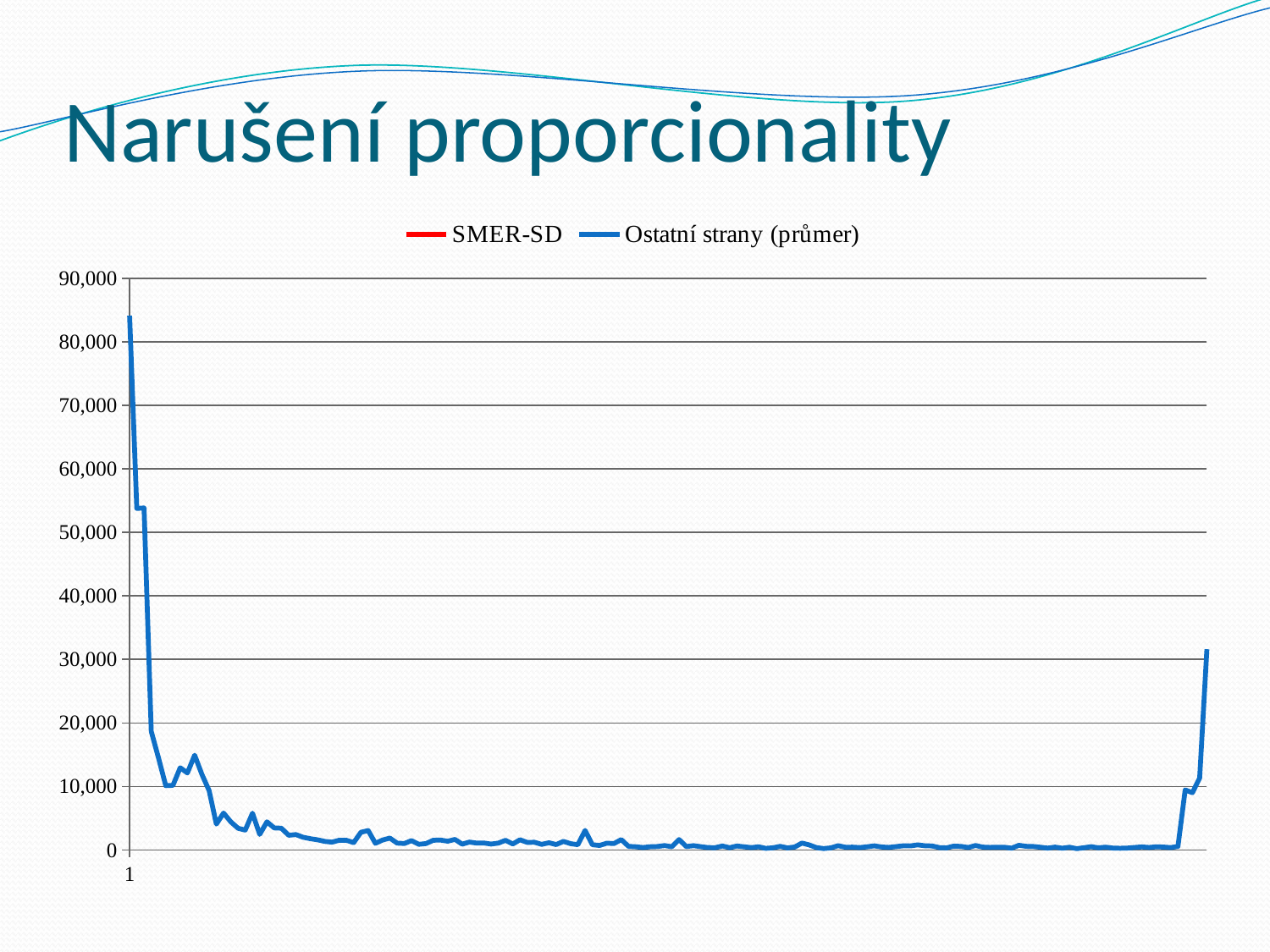
What are the two series named in the legend? SMER-SD and Ostatní strany (průmer) What colour is the line for Ostatní strany (průmer) in the legend? blue Where along the x axis does the Ostatní strany (průmer) line reach its highest value: at the start, in the middle, or at the end? at the start Is the first value of the Ostatní strany (průmer) line larger or smaller than its last value? larger Does the Ostatní strany (průmer) line rise or fall at the far right end of the chart? rise Does the Ostatní strany (průmer) line rise or fall over the first few points along the x axis? fall Is the first value of the Ostatní strany (průmer) line greater or less than 80,000? greater How many series does the legend list? 2 What kind of chart is shown on the slide? line chart Is the last value of the Ostatní strany (průmer) line greater or less than 20,000? greater Is the value of the Ostatní strany (průmer) line in the middle of the chart greater or less than 10,000? less What is the highest value shown on the vertical axis? 90,000